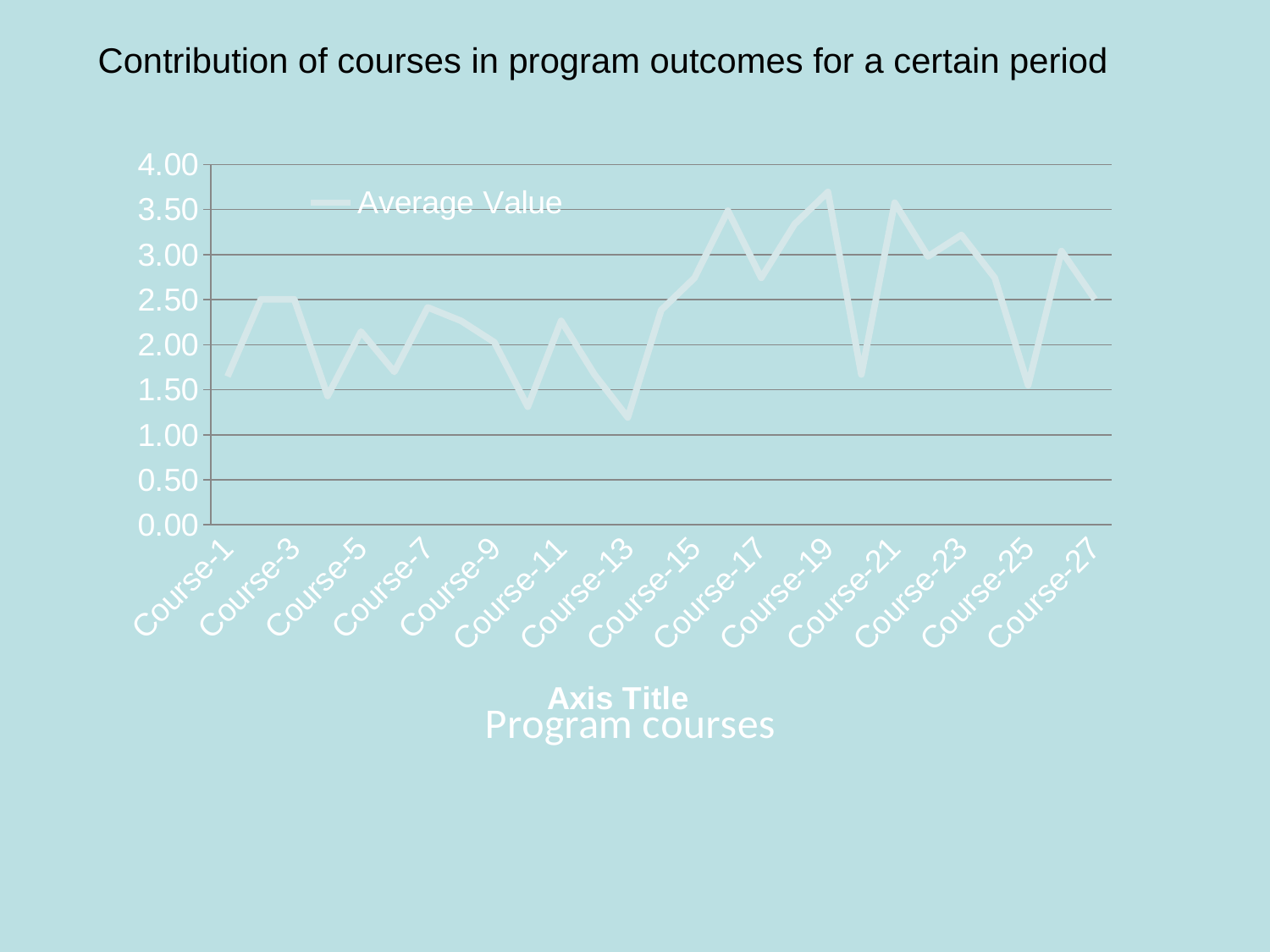
Is the value for Course-25 greater or less than 2.00? less Which has a larger average value, Course-19 or Course-1? Course-19 What is the title of the chart? Contribution of courses in program outcomes for a certain period Is the value for Course-13 greater or less than 1.50? less How many series does the legend list? 1 What is the name of the series shown in the legend? Average Value Is the value for Course-1 greater or less than 2.00? less What kind of chart is shown on the slide? Line chart Which course has the highest average value? Course-19